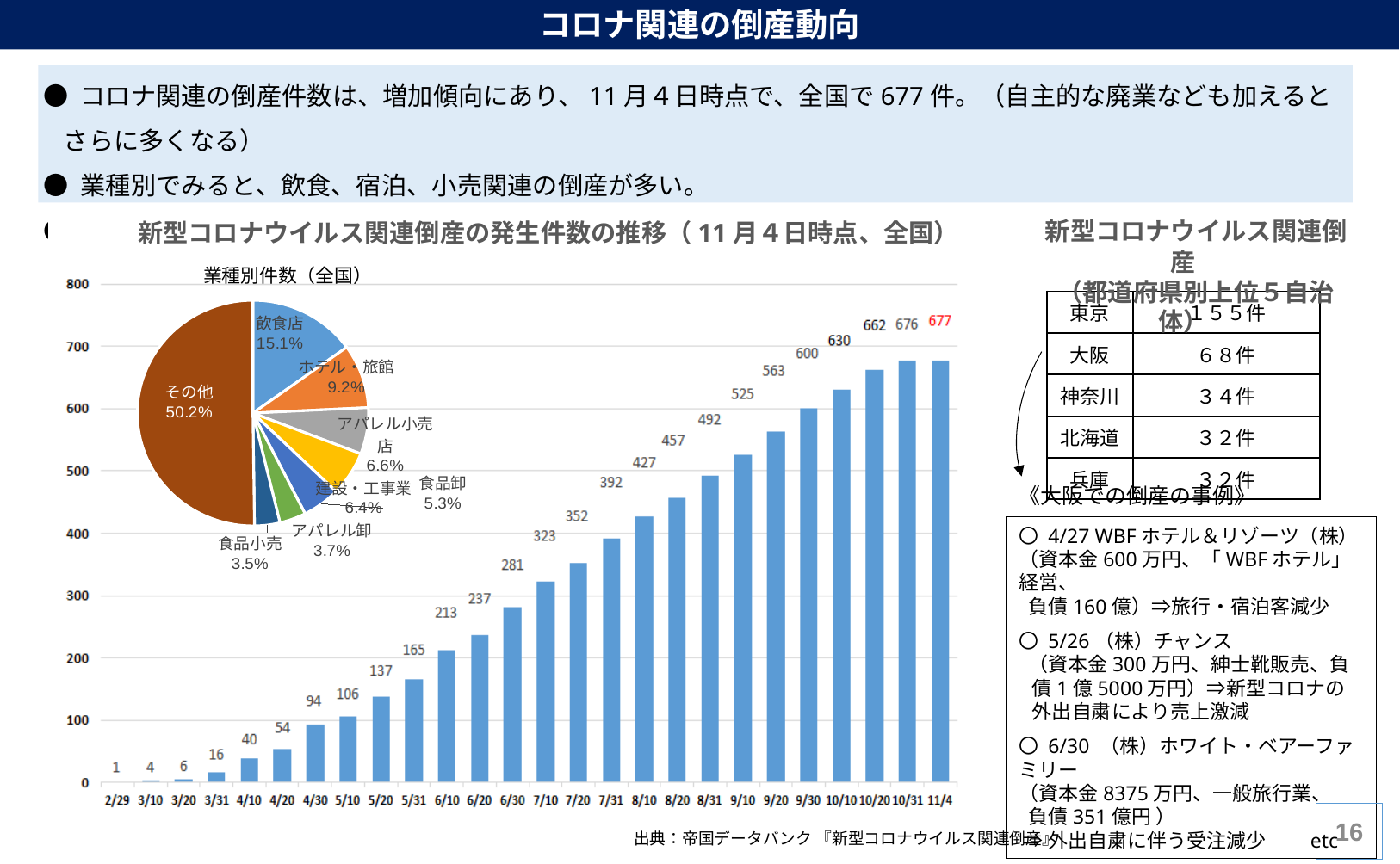
In the bar chart of cumulative COVID-related bankruptcies, what is the difference between the values for 9/30 and 8/31? 108 In the bar chart of cumulative COVID-related bankruptcies, which date has the lowest value? 2/29 In the bar chart of cumulative COVID-related bankruptcies, which date has the highest value? 11/4 In the bar chart of cumulative COVID-related bankruptcies, what is the value for 6/30? 281 In the bar chart of cumulative COVID-related bankruptcies, do the values rise or fall from 2/29 to 11/4? rise In the bar chart of cumulative COVID-related bankruptcies, what is the value for 3/31? 16 What kind of chart shows the 業種別件数（全国） breakdown? pie chart How many dates (bars) are shown in the bar chart of cumulative COVID-related bankruptcies? 26 In the bar chart of cumulative COVID-related bankruptcies, what is the value for 11/4? 677 In the 業種別件数（全国） pie chart, which category has the largest share? その他 In the 業種別件数（全国） pie chart, what share does 飲食店 have? 15.1% In the bar chart of cumulative COVID-related bankruptcies, which is larger, the value for 5/31 or the value for 7/10? 7/10